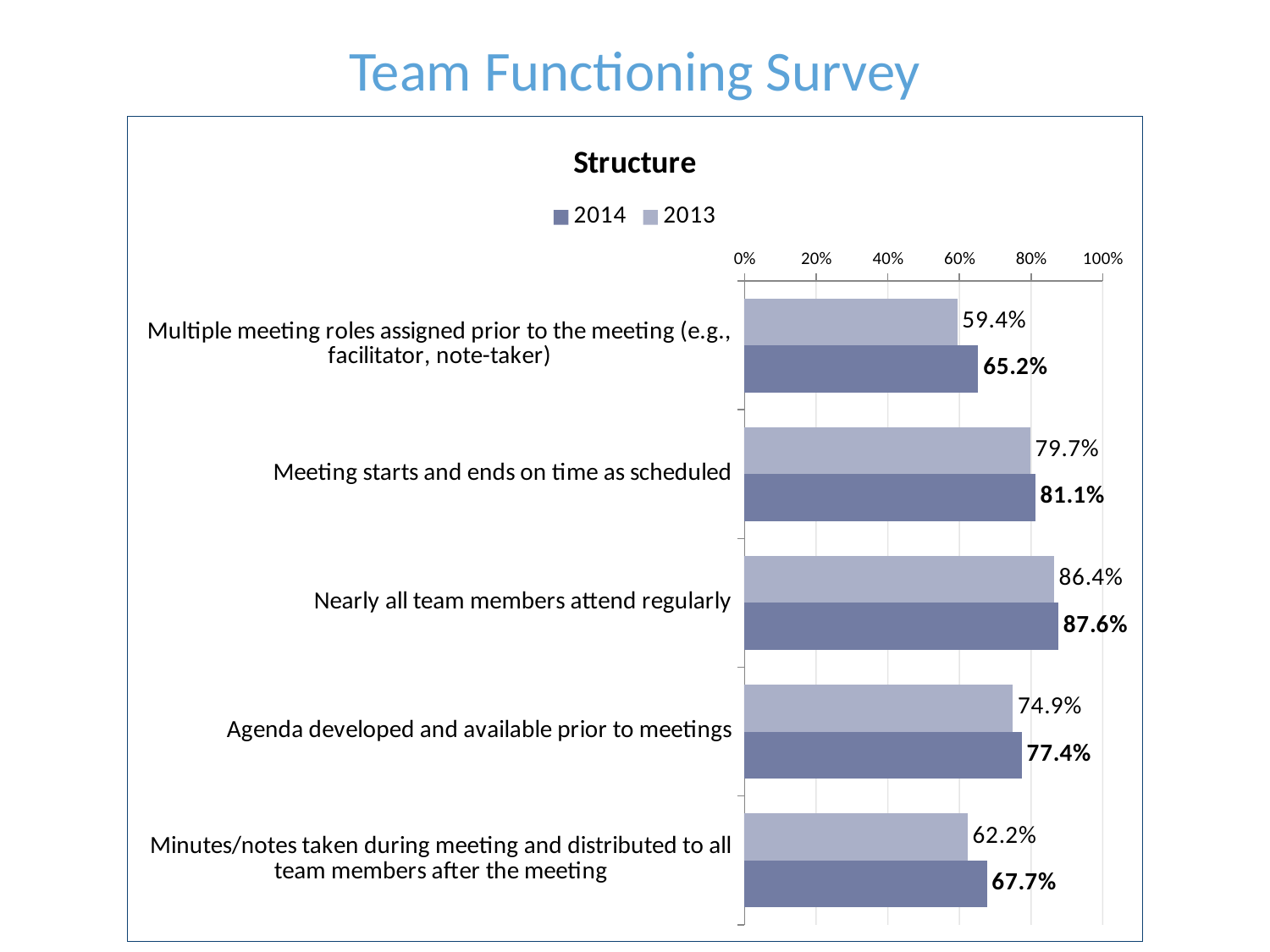
What is the 2013 value for "Multiple meeting roles assigned prior to the meeting (e.g., facilitator, note-taker)"? 59.4% How many categories are shown in the chart? 5 How many series does the legend list? 2 For "Agenda developed and available prior to meetings", which year has the larger value, 2014 or 2013? 2014 What is the 2014 value for "Minutes/notes taken during meeting and distributed to all team members after the meeting"? 67.7% What type of chart is shown on the slide? Bar chart Which category has the highest 2014 value? Nearly all team members attend regularly What is the 2014 value for "Meeting starts and ends on time as scheduled"? 81.1% What is the difference between the 2014 and 2013 values for "Multiple meeting roles assigned prior to the meeting (e.g., facilitator, note-taker)"? 5.8% What is the 2013 value for "Agenda developed and available prior to meetings"? 74.9% Which category has the lowest 2013 value? Multiple meeting roles assigned prior to the meeting (e.g., facilitator, note-taker) What is the difference between the 2014 and 2013 values for "Minutes/notes taken during meeting and distributed to all team members after the meeting"? 5.5%